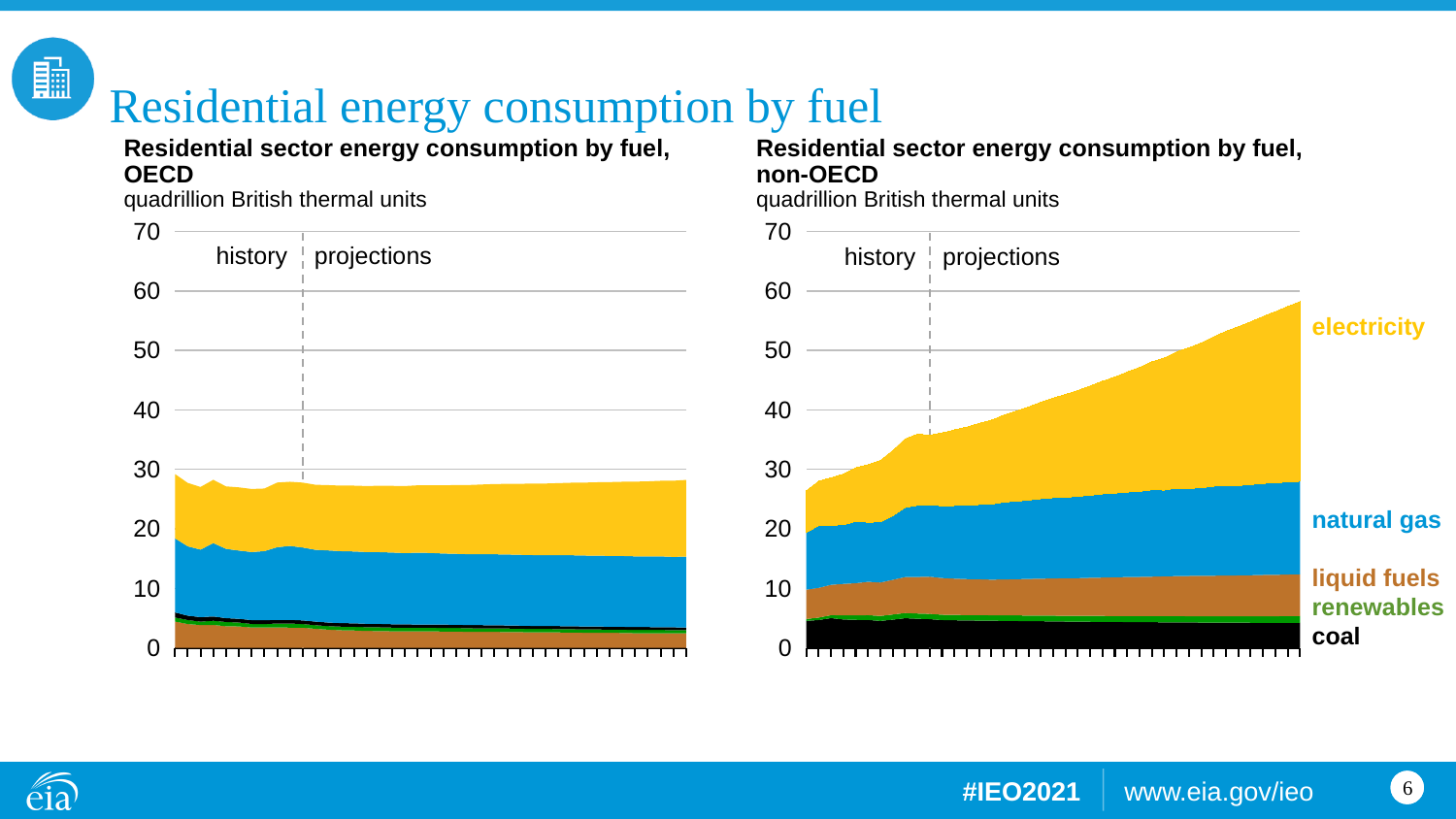
In the non-OECD chart, is the total residential energy consumption at the end of the projection period greater or less than 50? greater What unit is used on the y axis of both charts? quadrillion British thermal units In the OECD chart, is the total residential energy consumption at the start of the history period greater or less than 20? greater In the OECD chart, is the total residential energy consumption at the end of the projection period greater or less than 40? less In the non-OECD chart, which fuel accounts for the smallest share of residential energy consumption at the end of the projection period? renewables In the non-OECD chart, which fuel accounts for the largest share of residential energy consumption at the end of the projection period? electricity In the non-OECD chart, does total residential energy consumption rise or fall over the projection period? rise What kind of chart is the 'Residential sector energy consumption by fuel, OECD' chart? stacked area chart What is the maximum value shown on the y axis of the OECD chart? 70 At the end of the projection period, which region has higher total residential energy consumption, OECD or non-OECD? non-OECD How many fuel series are labelled on the 'Residential sector energy consumption by fuel, non-OECD' chart? 5